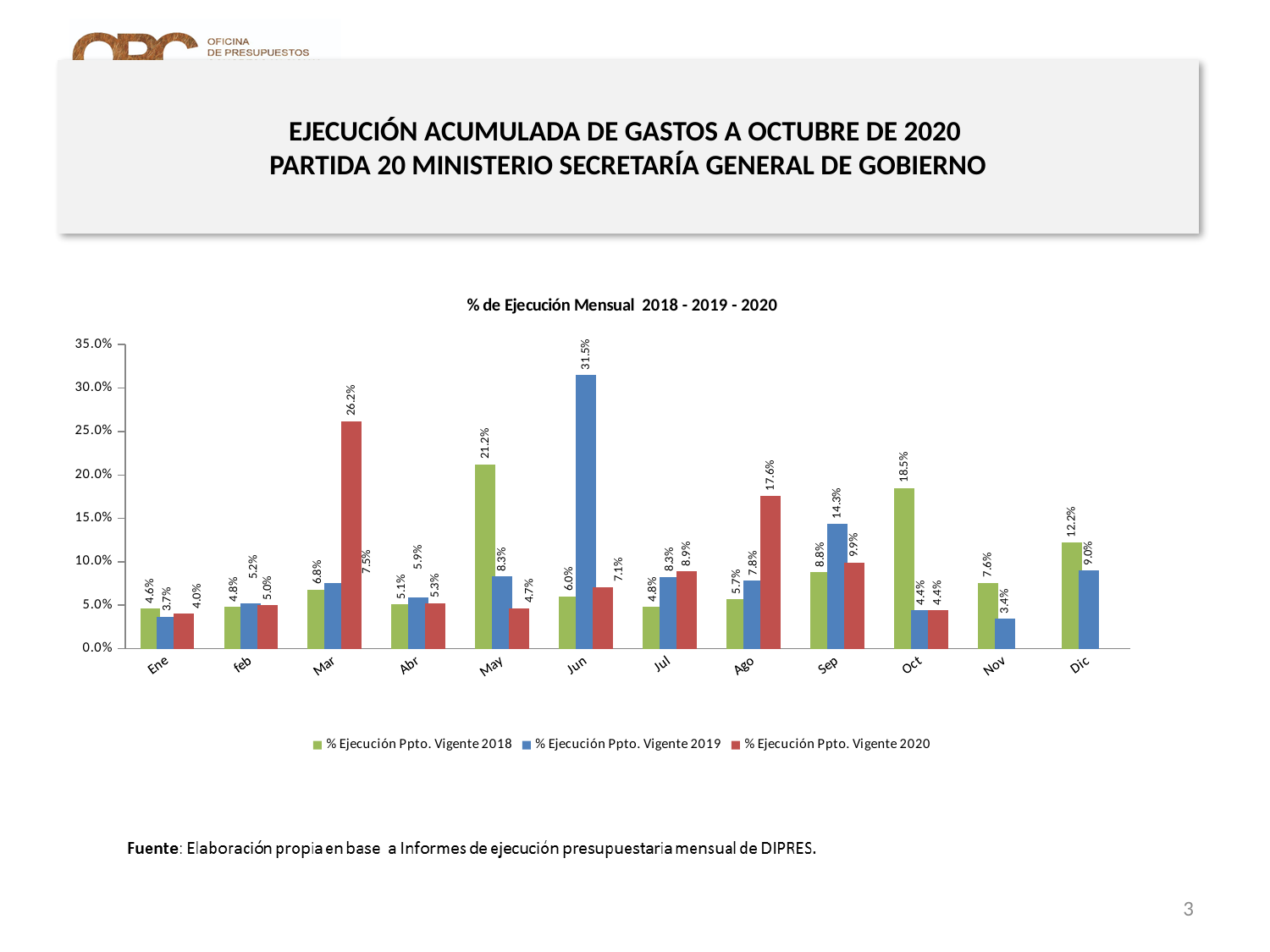
What kind of chart is shown on the slide? Bar chart What is the value for Oct in the % Ejecución Ppto. Vigente 2018 series? 18.5% Which month has the highest value in the % Ejecución Ppto. Vigente 2018 series? May Is the value for May in the 2018 series greater or less than 20.0%? greater Which month has the lowest value in the % Ejecución Ppto. Vigente 2019 series? Nov How many months are shown on the x axis? 12 What is the value for Mar in the % Ejecución Ppto. Vigente 2020 series? 26.2% What is the value for Jun in the % Ejecución Ppto. Vigente 2019 series? 31.5% What is the difference between the 2020 and 2018 values for Ago? 11.9% What is the title of the chart? % de Ejecución Mensual 2018 - 2019 - 2020 How many series does the legend list? 3 Which is larger for Sep: the 2019 value or the 2020 value? 2019 value (14.3%)